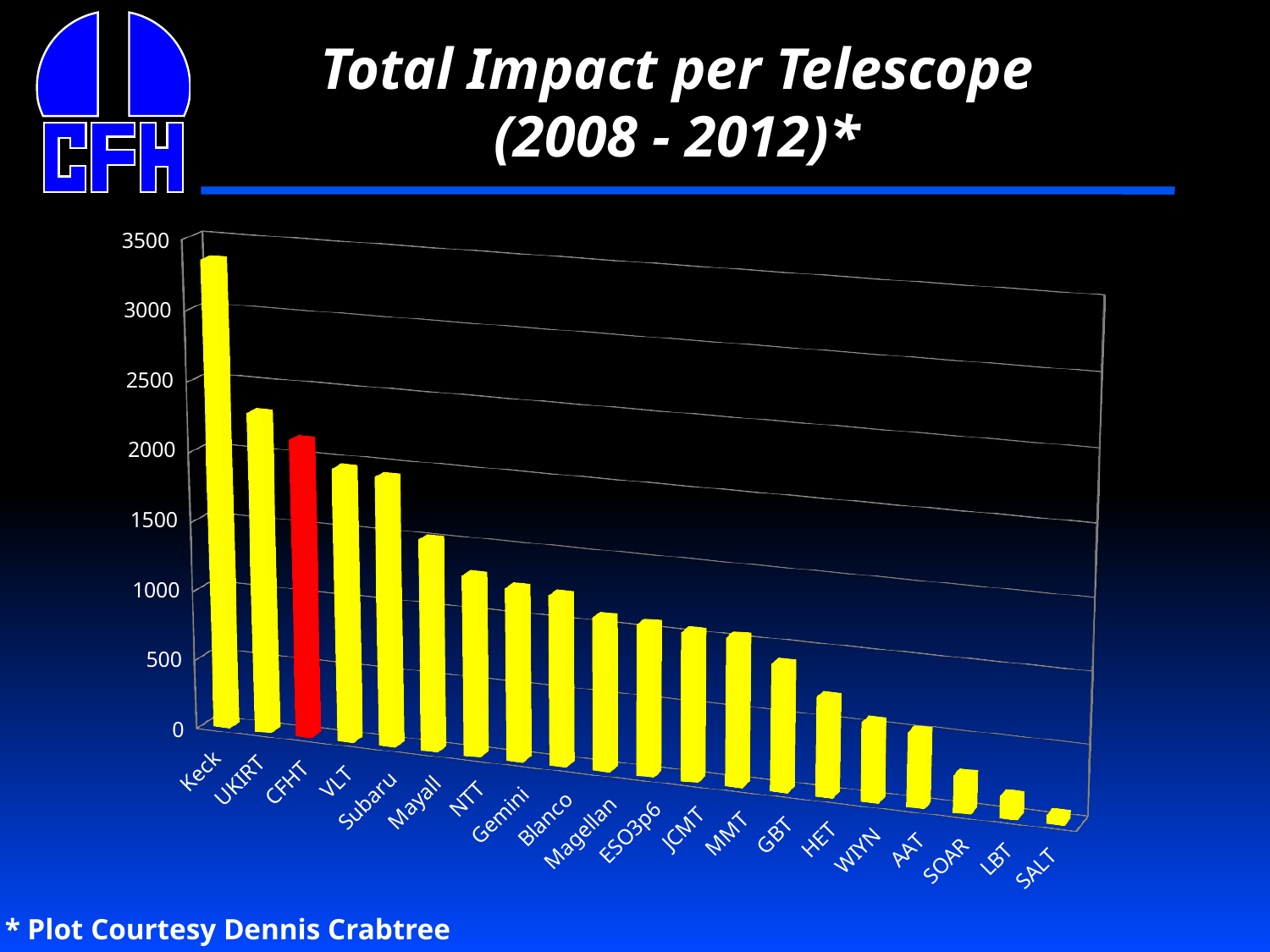
Is the value for Keck greater or less than 3000? greater Which has a larger total impact, Keck or UKIRT? Keck Is the value for HET greater or less than 500? greater Which telescope has the highest total impact? Keck Is the value for UKIRT greater or less than 2000? greater Which telescope's bar is coloured red instead of yellow? CFHT How many telescopes are shown on the x axis? 20 Do the values rise or fall moving from left to right along the x axis? fall What kind of chart is shown on the slide? bar chart Which telescope has the lowest total impact? SALT